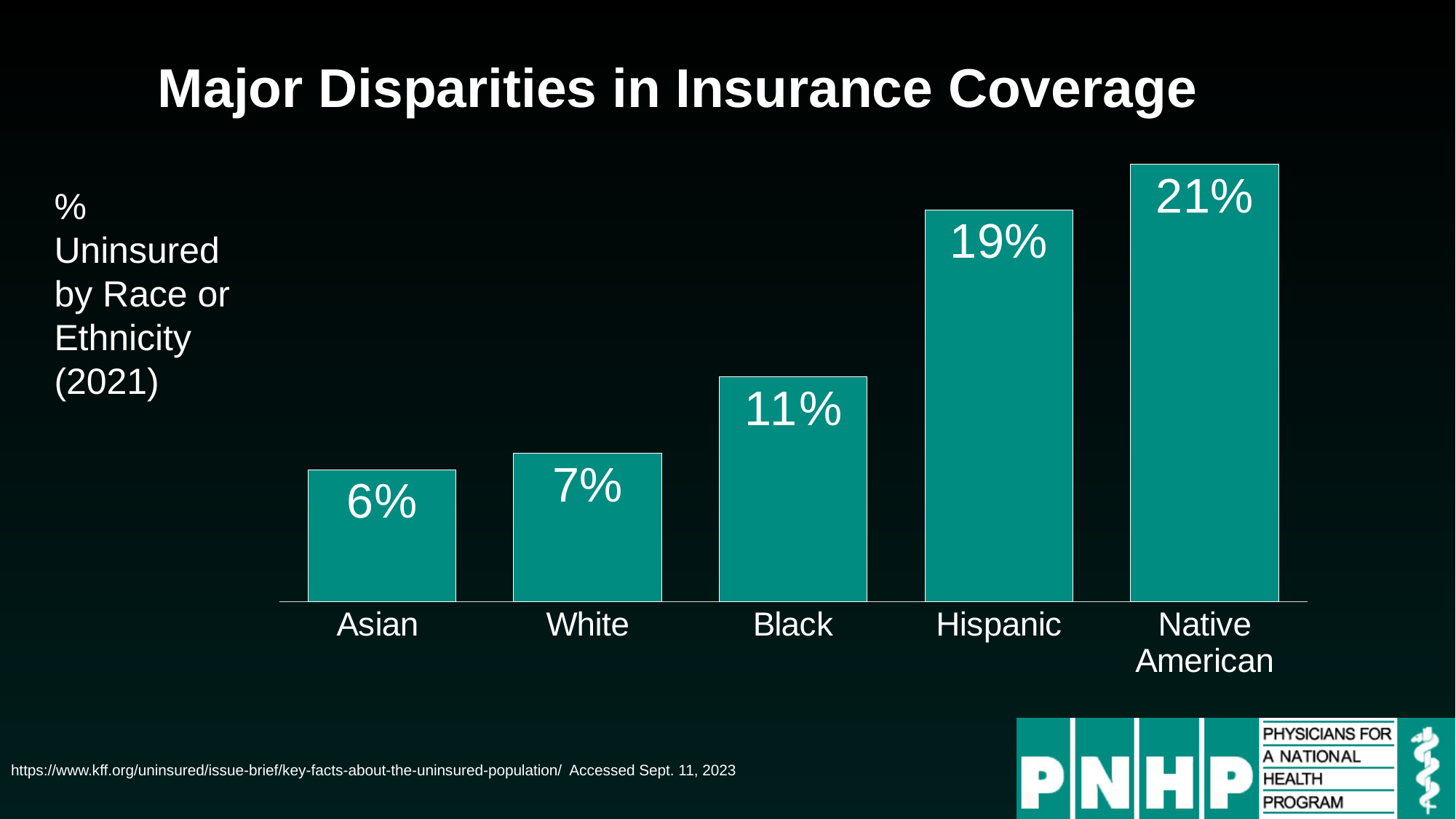
Which group has the lowest percentage uninsured? Asian What is the percentage uninsured for Black? 11% Which has a higher percentage uninsured, Black or White? Black What kind of chart is shown on the slide? Bar chart What is the title of the slide? Major Disparities in Insurance Coverage What is the difference in percentage uninsured between Native American and White? 14% Which group has the highest percentage uninsured? Native American What is the percentage uninsured for Hispanic? 19% What is the difference in percentage uninsured between Hispanic and Black? 8% How many racial or ethnic groups are shown in the chart? 5 What is the percentage uninsured for Asian? 6% Do the values rise or fall from left to right across the groups? Rise